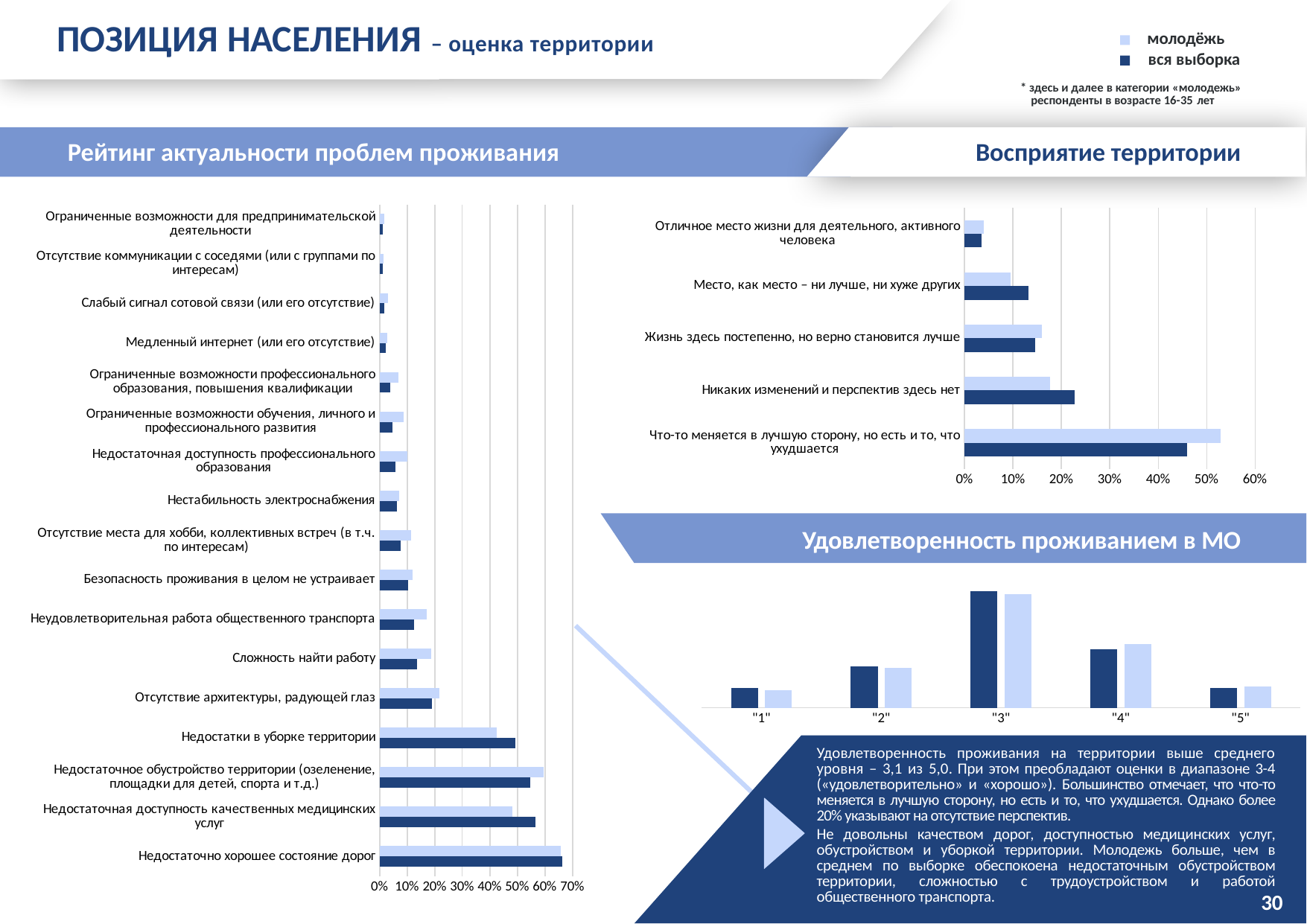
In the chart 'Рейтинг актуальности проблем проживания', is the 'вся выборка' value for 'Недостаточная доступность качественных медицинских услуг' greater or less than 50%? greater In the chart 'Восприятие территории', which statement has the lowest value for 'молодёжь'? Отличное место жизни для деятельного, активного человека In the chart 'Рейтинг актуальности проблем проживания', which problem has the highest value for 'вся выборка'? Недостаточно хорошее состояние дорог How many series does the legend at the top of the slide list? 2 In the chart 'Рейтинг актуальности проблем проживания', is the 'молодёжь' value for 'Неудовлетворительная работа общественного транспорта' greater or less than 20%? less In the chart 'Рейтинг актуальности проблем проживания', is the 'молодёжь' value for 'Недостатки в уборке территории' greater or less than 50%? less In the chart 'Удовлетворенность проживанием в МО', which rating has the highest bars? "3" In the chart 'Удовлетворенность проживанием в МО', which is larger for 'вся выборка': rating "2" or rating "4"? "4" How many problem categories are listed in the chart 'Рейтинг актуальности проблем проживания'? 17 In the chart 'Восприятие территории', which statement has the highest value for 'вся выборка'? Что-то меняется в лучшую сторону, но есть и то, что ухудшается